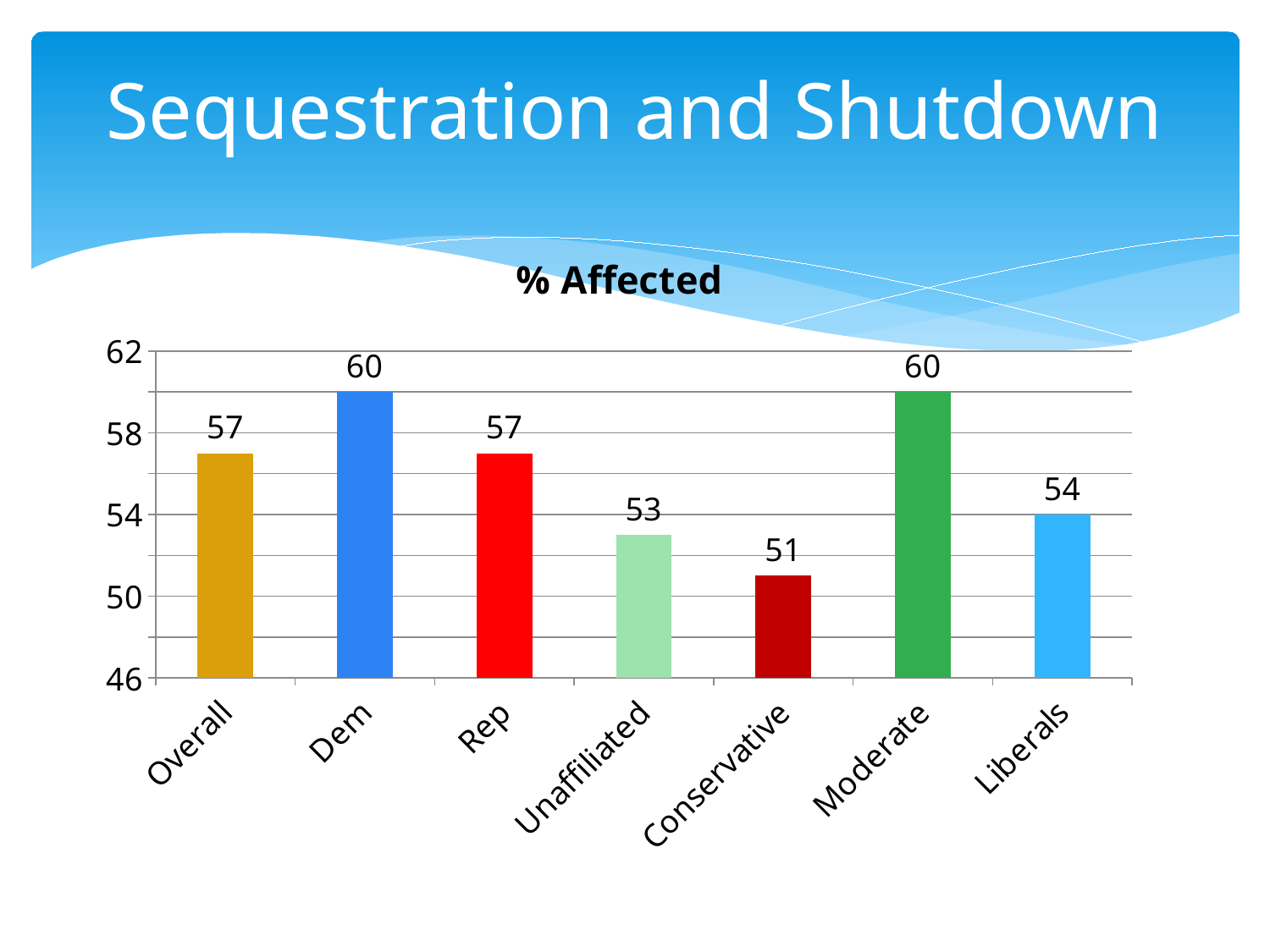
Which category has the lowest value? Conservative What is the value for Dem? 60 What is the difference between the values for Moderate and Conservative? 9 Is the value for Conservative greater or less than 54? less What is the value for Liberals? 54 What is the value for Conservative? 51 What is the title of the chart? % Affected What kind of chart is shown on the slide? bar chart Which is larger, the value for Rep or the value for Unaffiliated? Rep What is the value for Unaffiliated? 53 What is the difference between the values for Overall and Liberals? 3 How many categories are shown on the x axis? 7